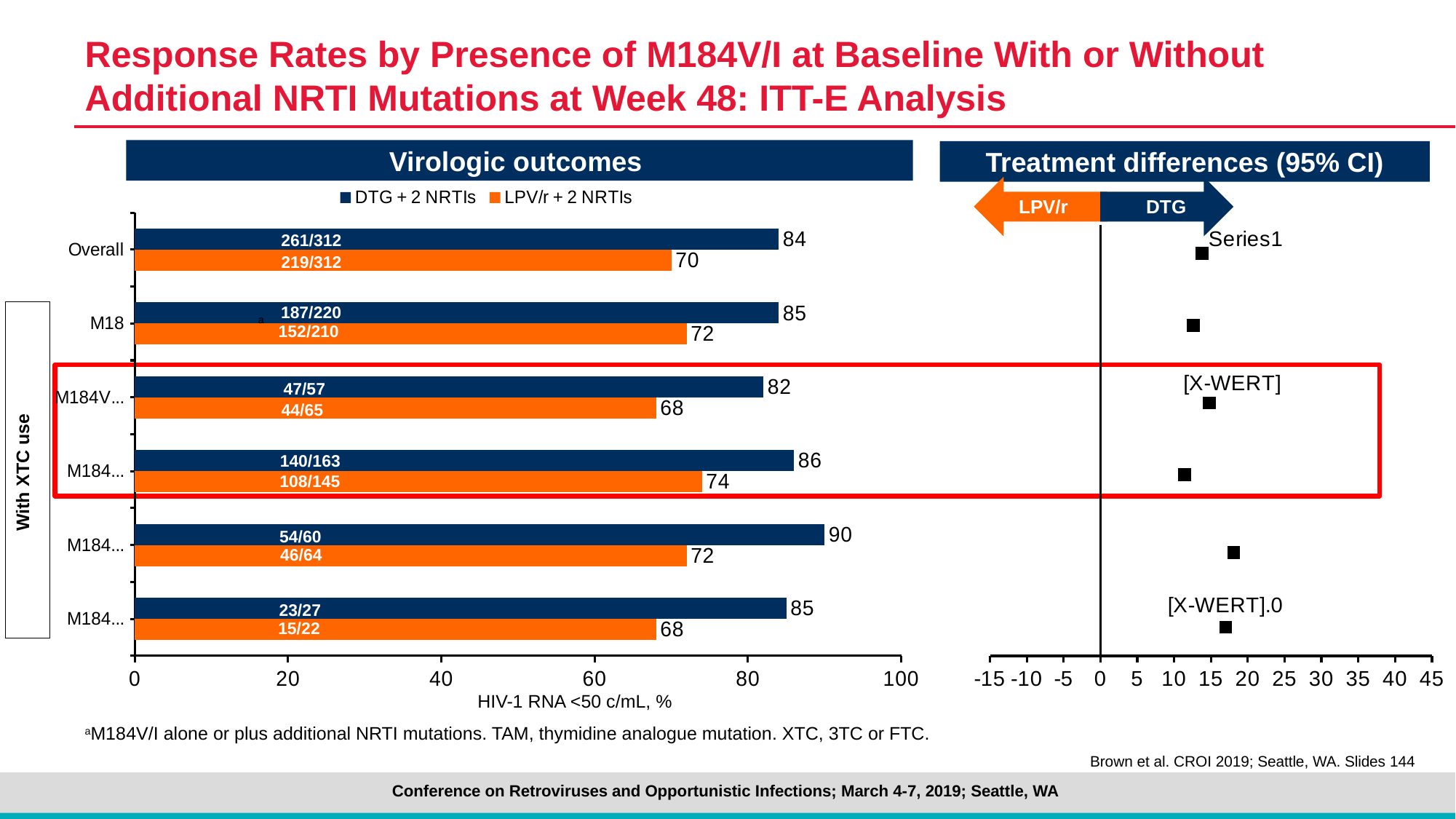
In the Virologic outcomes chart, what is the response rate for LPV/r + 2 NRTIs in the Overall category? 70 In the Virologic outcomes chart, what is the response rate for DTG + 2 NRTIs in the Overall category? 84 In the Virologic outcomes chart, is the Overall value for LPV/r + 2 NRTIs greater or less than 80? less In the Virologic outcomes chart, how many series does the legend list? 2 What is the label of the horizontal axis of the Virologic outcomes chart? HIV-1 RNA <50 c/mL, % In the Virologic outcomes chart, what is the highest response rate shown for DTG + 2 NRTIs? 90 In the Virologic outcomes chart, which series has the larger response rate in the Overall category? DTG + 2 NRTIs In the Virologic outcomes chart, how many categories are plotted on the vertical axis? 6 In the Virologic outcomes chart, what is the lowest response rate shown for LPV/r + 2 NRTIs? 68 In the Virologic outcomes chart, what kind of chart is used to show the response rates? bar chart In the Virologic outcomes chart, what is the difference between the DTG + 2 NRTIs and LPV/r + 2 NRTIs response rates in the Overall category? 14 In the Virologic outcomes chart, what fraction is printed on the DTG + 2 NRTIs bar for the Overall category? 261/312